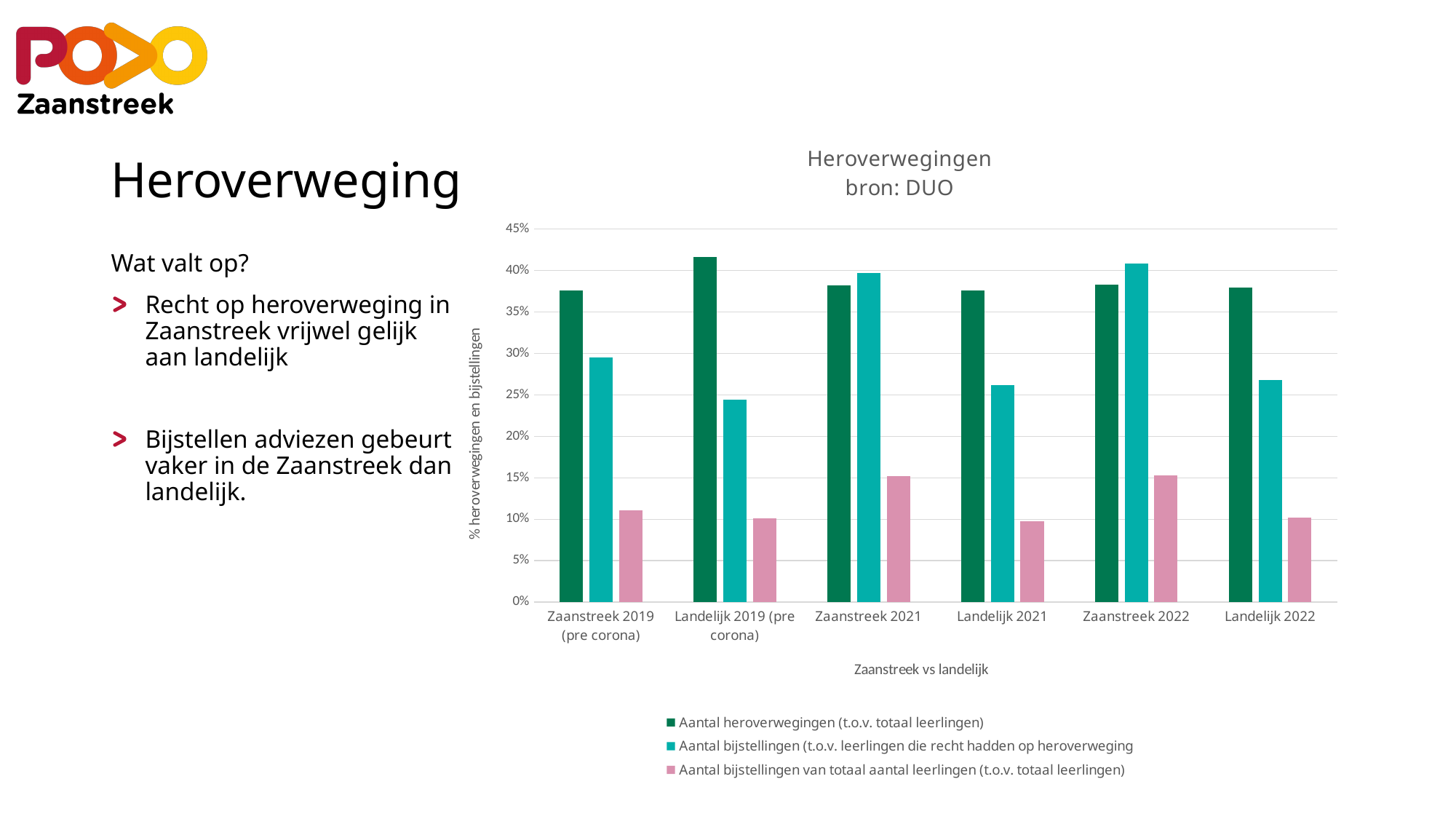
How many series does the chart's legend list? 3 What kind of chart is shown on the slide? Bar chart For 'Aantal heroverwegingen (t.o.v. totaal leerlingen)', which is larger: Zaanstreek 2019 (pre corona) or Landelijk 2019 (pre corona)? Landelijk 2019 (pre corona) Is the value for 'Aantal bijstellingen (t.o.v. leerlingen die recht hadden op heroverweging' in Zaanstreek 2019 (pre corona) greater or less than 25%? greater Which category has the highest value for 'Aantal heroverwegingen (t.o.v. totaal leerlingen)'? Landelijk 2019 (pre corona) Which category has the highest value for 'Aantal bijstellingen (t.o.v. leerlingen die recht hadden op heroverweging'? Zaanstreek 2022 Is the value for 'Aantal heroverwegingen (t.o.v. totaal leerlingen)' in Landelijk 2019 (pre corona) greater or less than 40%? greater How many categories are shown along the x axis of the chart? 6 What is the title of the chart? Heroverwegingen bron: DUO For 'Aantal bijstellingen (t.o.v. leerlingen die recht hadden op heroverweging', which is larger: Zaanstreek 2021 or Landelijk 2021? Zaanstreek 2021 Is the value for 'Aantal bijstellingen van totaal aantal leerlingen (t.o.v. totaal leerlingen)' in Landelijk 2021 greater or less than 15%? less Which category has the lowest value for 'Aantal bijstellingen (t.o.v. leerlingen die recht hadden op heroverweging'? Landelijk 2019 (pre corona)